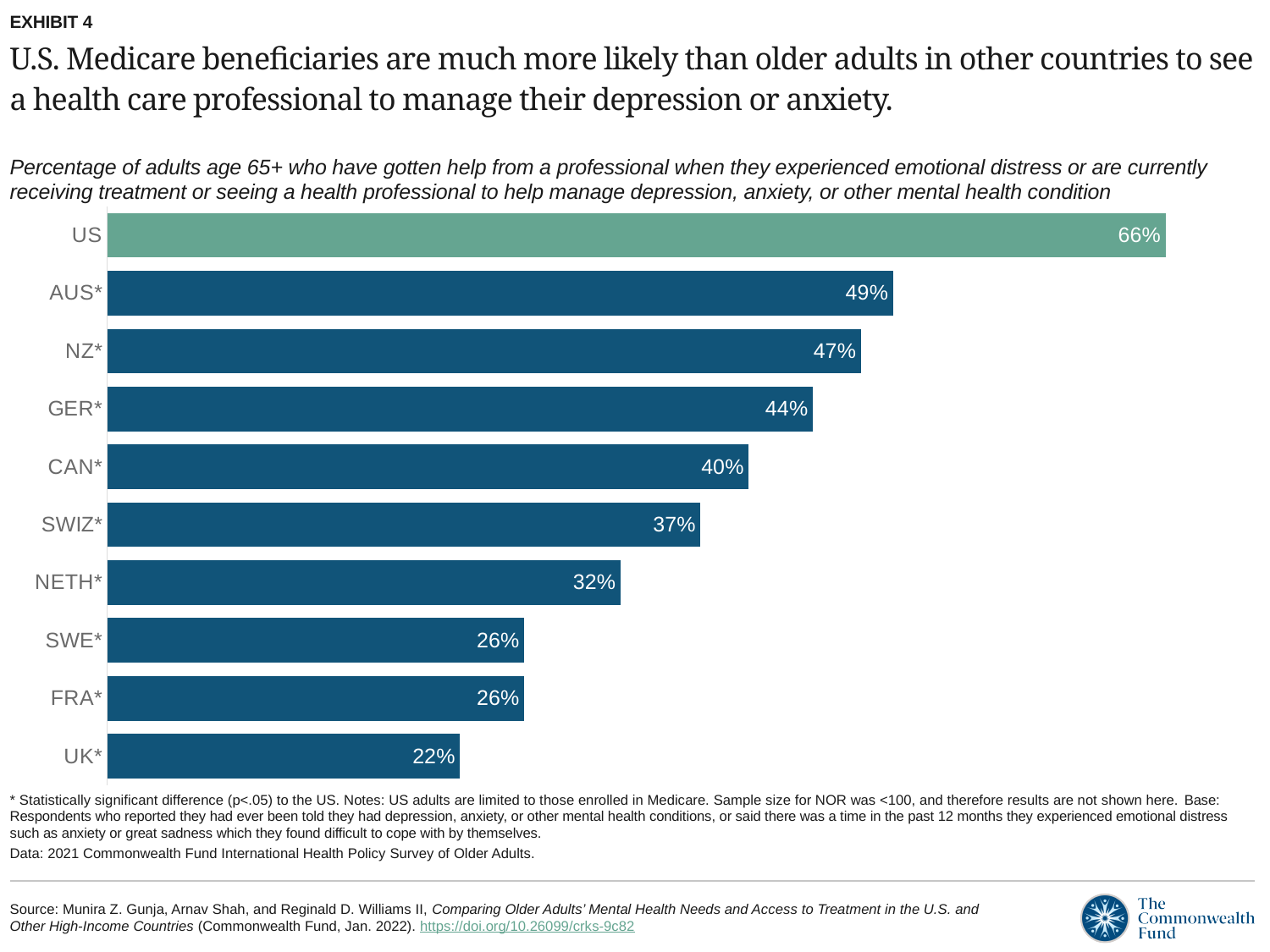
What type of chart is shown? Bar chart What percentage is shown for the US? 66% What percentage is shown for NETH*? 32% Which two countries share the same percentage of 26%? SWE* and FRA* Which country has the highest percentage? US How many countries are shown in the chart? 10 What percentage is shown for GER*? 44% Which bar is shown in a different colour from the others? US What is the difference in percentage points between CAN* and UK*? 18 Which has a higher percentage, NZ* or SWIZ*? NZ* Which country has the lowest percentage? UK* What is the difference in percentage points between the US and AUS*? 17